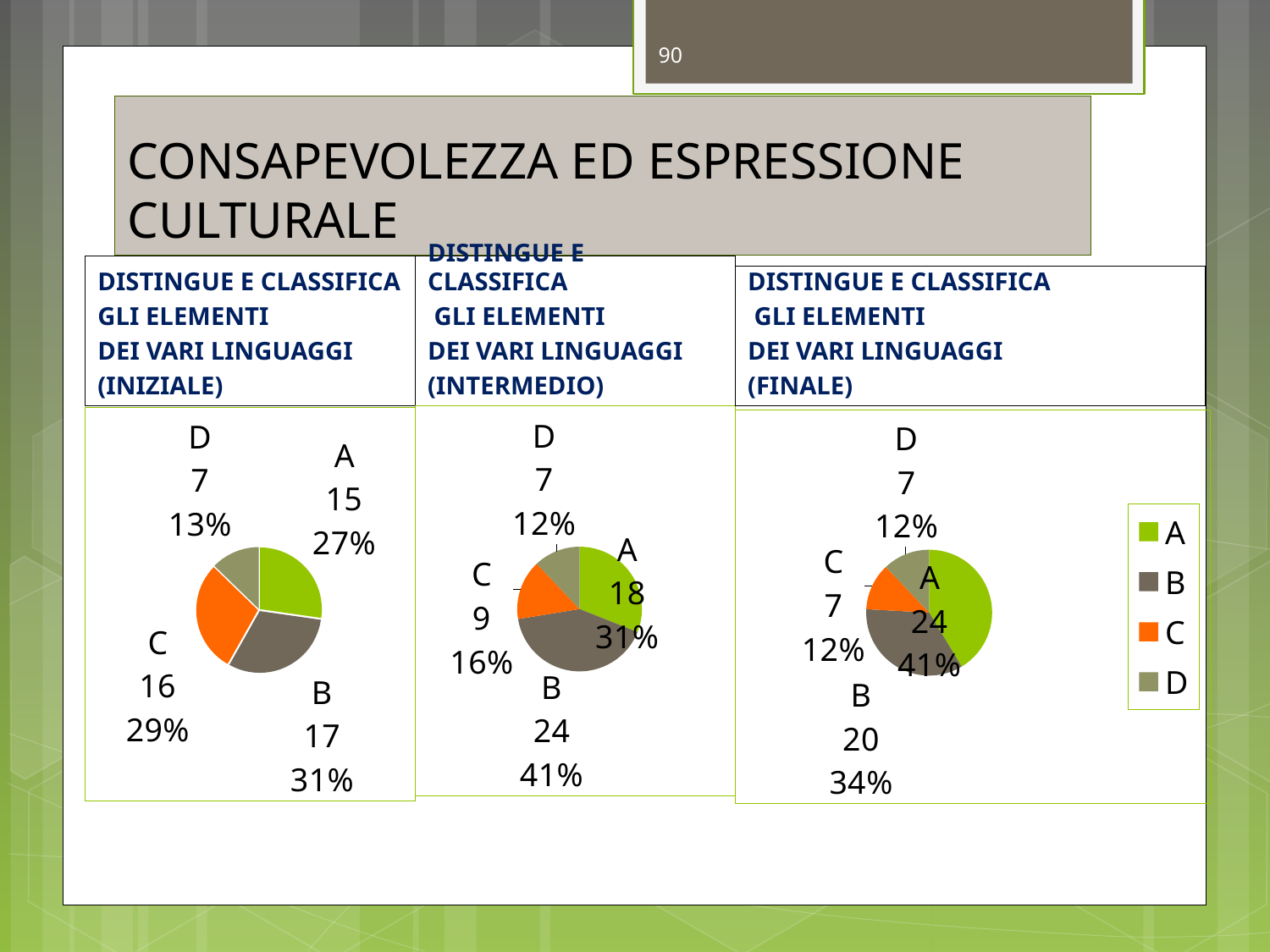
In the INIZIALE pie chart, which category has the lowest value? D How many entries does the legend next to the FINALE chart list? 4 In the FINALE pie chart, what is the value for category B? 20 In the INTERMEDIO pie chart, which category has the highest value? B What type of chart is used in the FINALE panel? Pie chart In the INTERMEDIO pie chart, what is the difference between the values for B and C? 15 In the FINALE pie chart, what percentage share does category A have? 41% In the INTERMEDIO pie chart, what is the value for category A? 18 In the FINALE pie chart, which is larger, the value for A or the value for B? A How many categories does the INIZIALE pie chart show? 4 In the INIZIALE pie chart, what is the value for category B? 17 In the INIZIALE pie chart, what percentage share does category D have? 13%